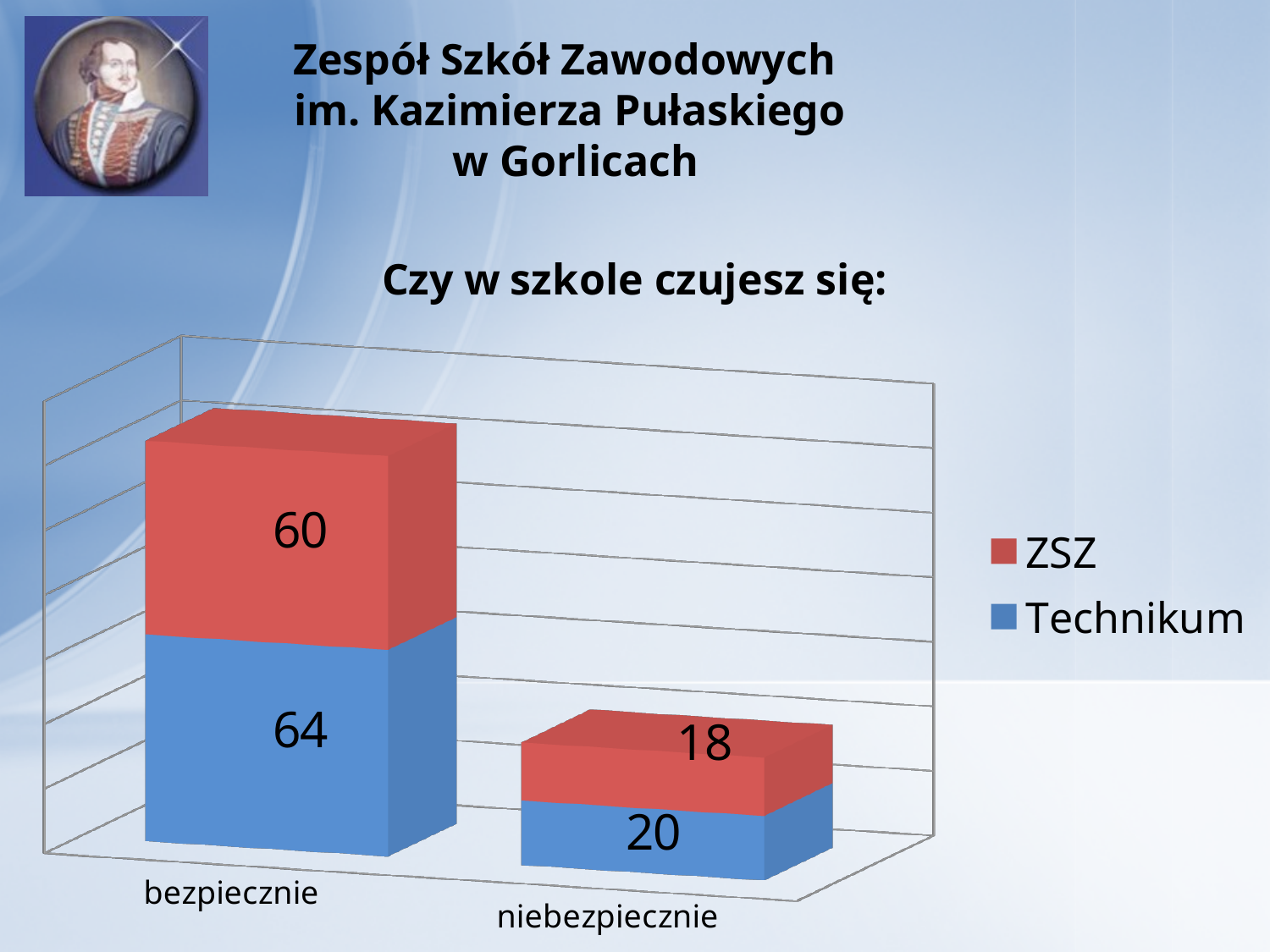
What is the value for Technikum in the niebezpiecznie category? 20 How many series does the legend list? 2 What is the value for ZSZ in the niebezpiecznie category? 18 What is the value for Technikum in the bezpiecznie category? 64 What is the difference between the Technikum values for bezpiecznie and niebezpiecznie? 44 What is the total of the stacked bar for bezpiecznie? 124 How many categories are shown on the x axis? 2 What is the total of the stacked bar for niebezpiecznie? 38 Which series has the larger value in the bezpiecznie category? Technikum What is the value for ZSZ in the bezpiecznie category? 60 Which category has the higher total, bezpiecznie or niebezpiecznie? bezpiecznie What kind of chart is shown on the slide? stacked bar chart